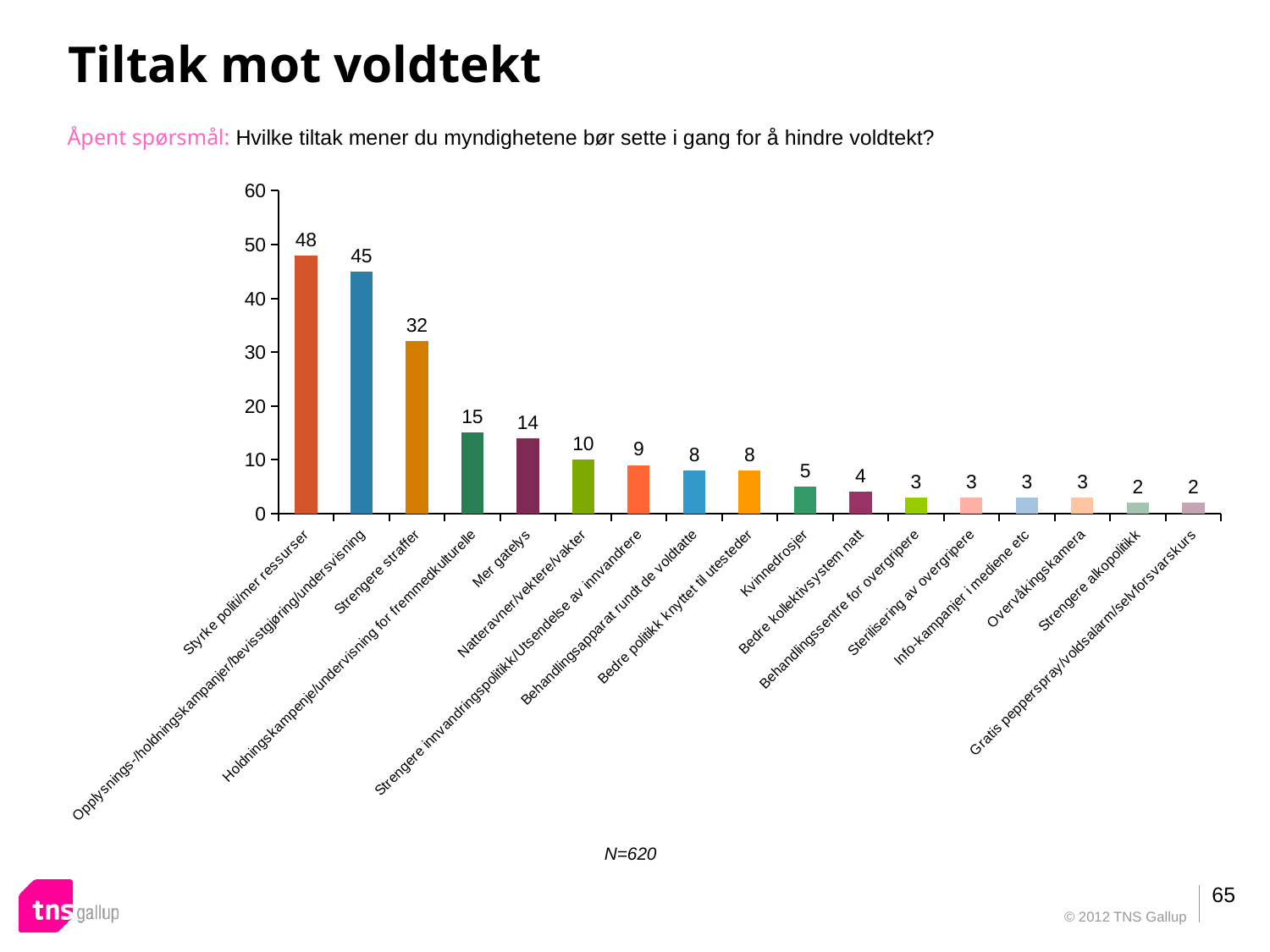
Which is larger, the value for Natteravner/vektere/vakter or the value for Kvinnedrosjer? Natteravner/vektere/vakter Is the value for Strengere straffer greater or less than 30? greater What is the value for Styrke politi/mer ressurser? 48 What kind of chart is shown on the slide? Bar chart Which category has the highest value? Styrke politi/mer ressurser How many categories are shown in the chart? 17 What is the value for Strengere straffer? 32 What is the sample size (N) stated below the chart? N=620 What is the value for Kvinnedrosjer? 5 What is the difference between the values for Styrke politi/mer ressurser and Strengere straffer? 16 What is the difference between the values for Holdningskampenje/undervisning for fremmedkulturelle and Mer gatelys? 1 What is the value for Mer gatelys? 14